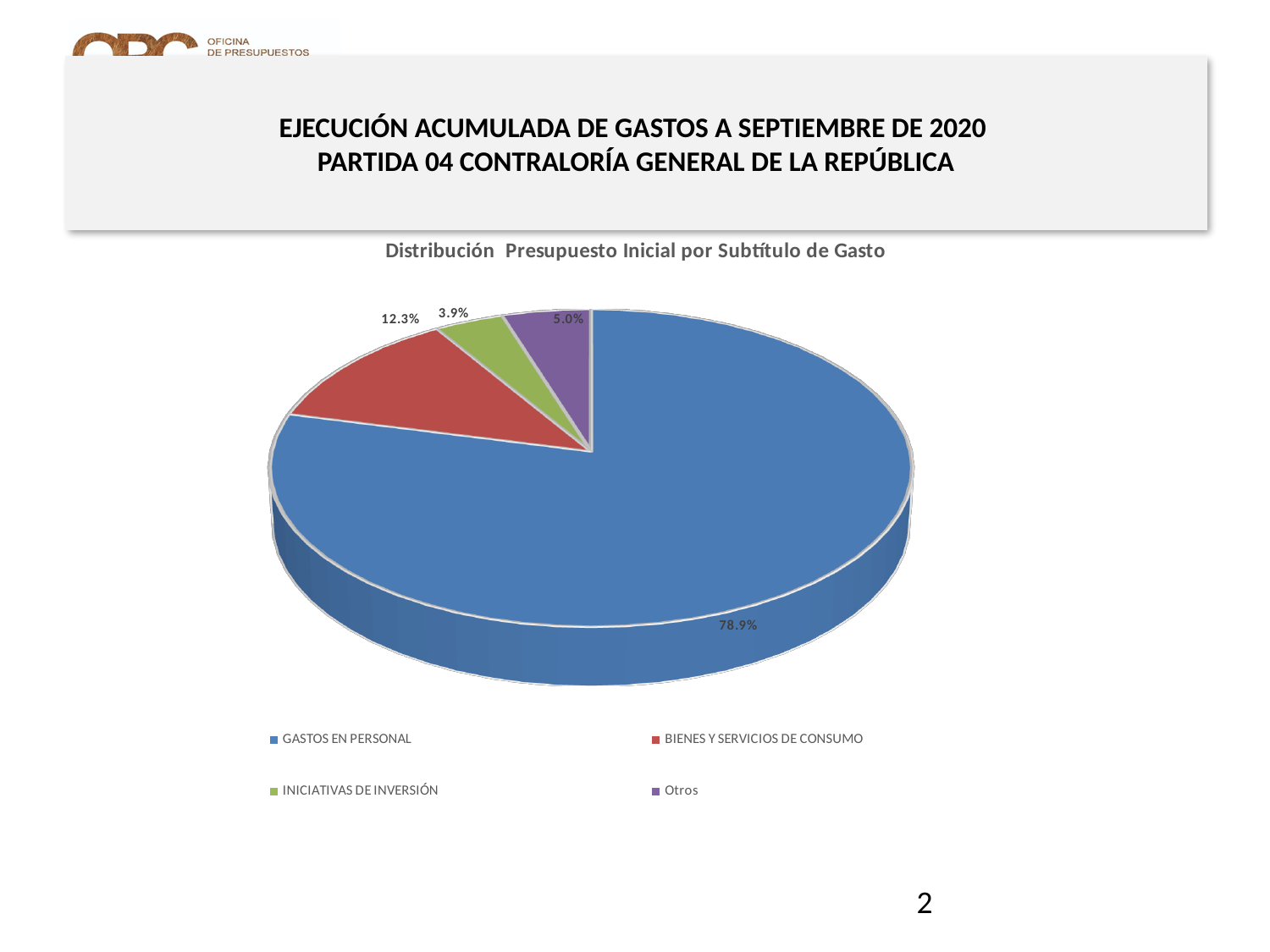
What share of the pie does BIENES Y SERVICIOS DE CONSUMO represent? 12.3% What share of the pie does INICIATIVAS DE INVERSIÓN represent? 3.9% What share of the pie does Otros represent? 5.0% Which is larger, the share for BIENES Y SERVICIOS DE CONSUMO or the share for Otros? BIENES Y SERVICIOS DE CONSUMO What is the difference in percentage points between Otros and INICIATIVAS DE INVERSIÓN? 1.1 Which category has the smallest slice of the pie? INICIATIVAS DE INVERSIÓN Which category has the largest slice of the pie? GASTOS EN PERSONAL What is the title of the chart? Distribución Presupuesto Inicial por Subtítulo de Gasto What kind of chart is shown on the slide? Pie chart What is the difference in percentage points between GASTOS EN PERSONAL and BIENES Y SERVICIOS DE CONSUMO? 66.6 How many categories does the pie chart show? 4